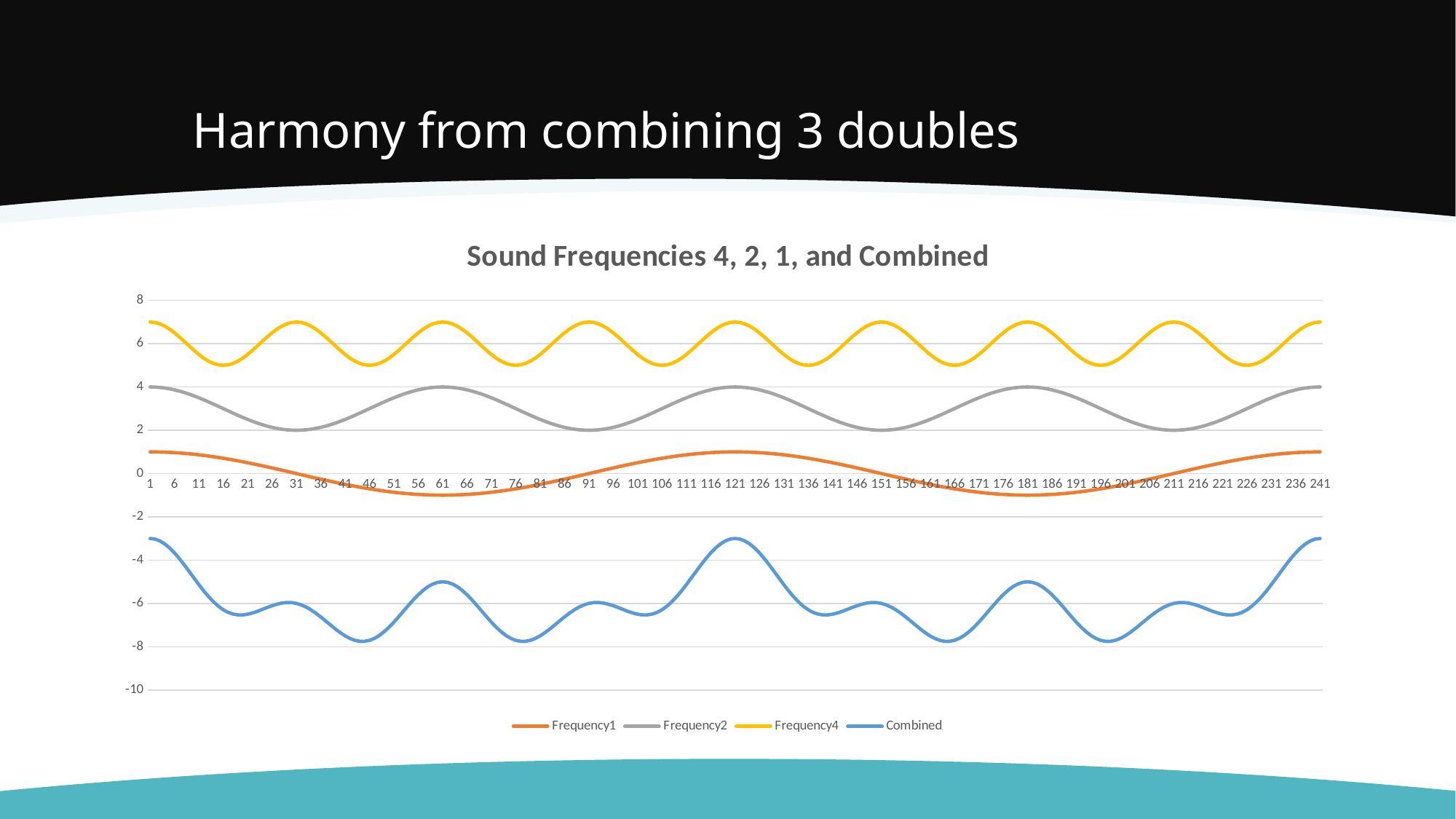
Which series has the highest values on the chart? Frequency4 Is the value for Combined at x = 46 greater or less than -6? less Is the value for Frequency4 at x = 1 greater or less than 6? greater Is the value for Frequency1 at x = 61 greater or less than 0? less Which is larger at x = 1, the value for Frequency4 or the value for Combined? Frequency4 What is the title of the chart? Sound Frequencies 4, 2, 1, and Combined Which series has the lowest values on the chart? Combined What kind of chart is shown on the slide? line chart What is the last label shown on the x axis? 241 How many series does the legend list? 4 Which is larger at x = 31, the value for Frequency2 or the value for Frequency1? Frequency2